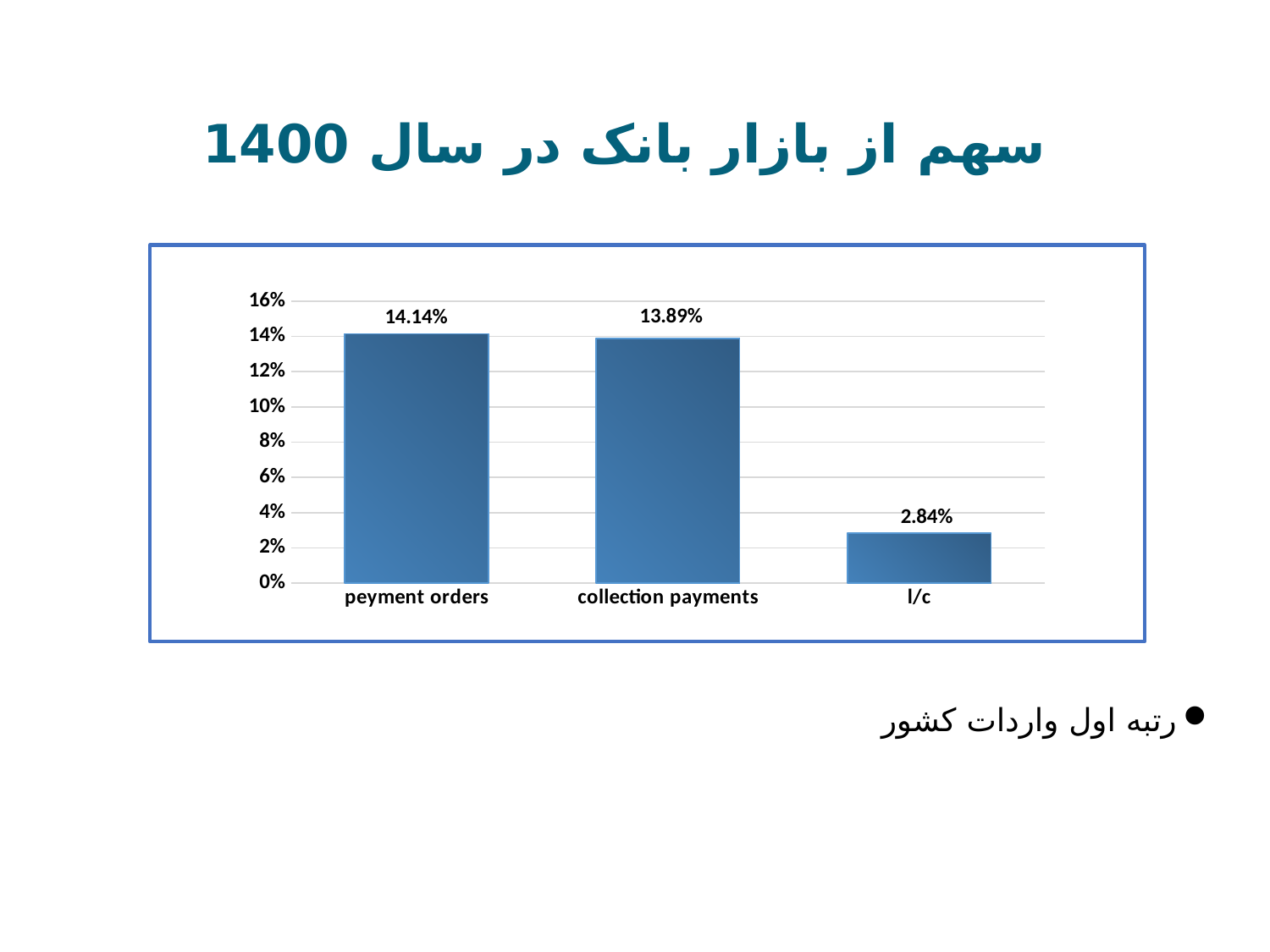
Which category has the lowest value? l/c What is the difference between the values for collection payments and l/c? 11.05% Which is larger, the value for collection payments or the value for l/c? collection payments What is the highest value shown on the y axis? 16% What is the difference between the values for peyment orders and collection payments? 0.25% Which category has the highest value? peyment orders What kind of chart is shown on the slide? bar chart How many categories are shown on the x axis? 3 What is the value for l/c? 2.84% Is the value for l/c greater or less than 4%? less What is the value for collection payments? 13.89% What is the value for peyment orders? 14.14%